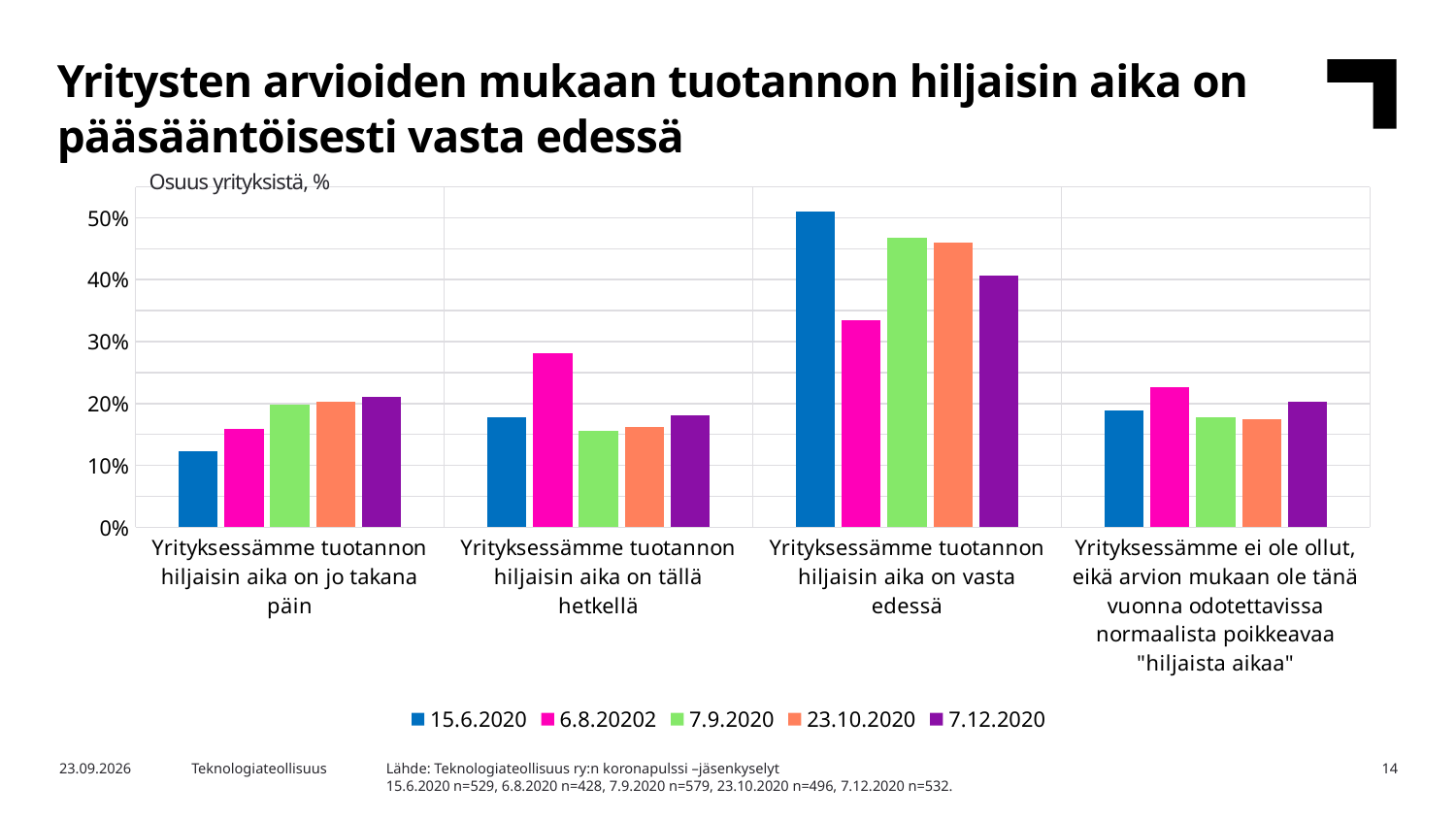
Is the 6.8.20202 value for "Yrityksessämme tuotannon hiljaisin aika on tällä hetkellä" greater or less than 20%? greater For the 15.6.2020 series, which category has the highest value? Yrityksessämme tuotannon hiljaisin aika on vasta edessä What is the label shown above the vertical axis of the chart? Osuus yrityksistä, % How many categories are shown on the x axis? 4 How many series does the legend list? 5 In the category "Yrityksessämme tuotannon hiljaisin aika on jo takana päin", do the values rise or fall from the 15.6.2020 series to the 7.12.2020 series? rise What kind of chart is shown on the slide? bar chart Is the 15.6.2020 value for "Yrityksessämme tuotannon hiljaisin aika on jo takana päin" greater or less than 20%? less In the category "Yrityksessämme tuotannon hiljaisin aika on vasta edessä", which is larger: the 15.6.2020 value or the 6.8.20202 value? 15.6.2020 Is the 7.12.2020 value for "Yrityksessämme tuotannon hiljaisin aika on vasta edessä" greater or less than 30%? greater In the category "Yrityksessämme tuotannon hiljaisin aika on vasta edessä", which series has the lowest value? 6.8.20202